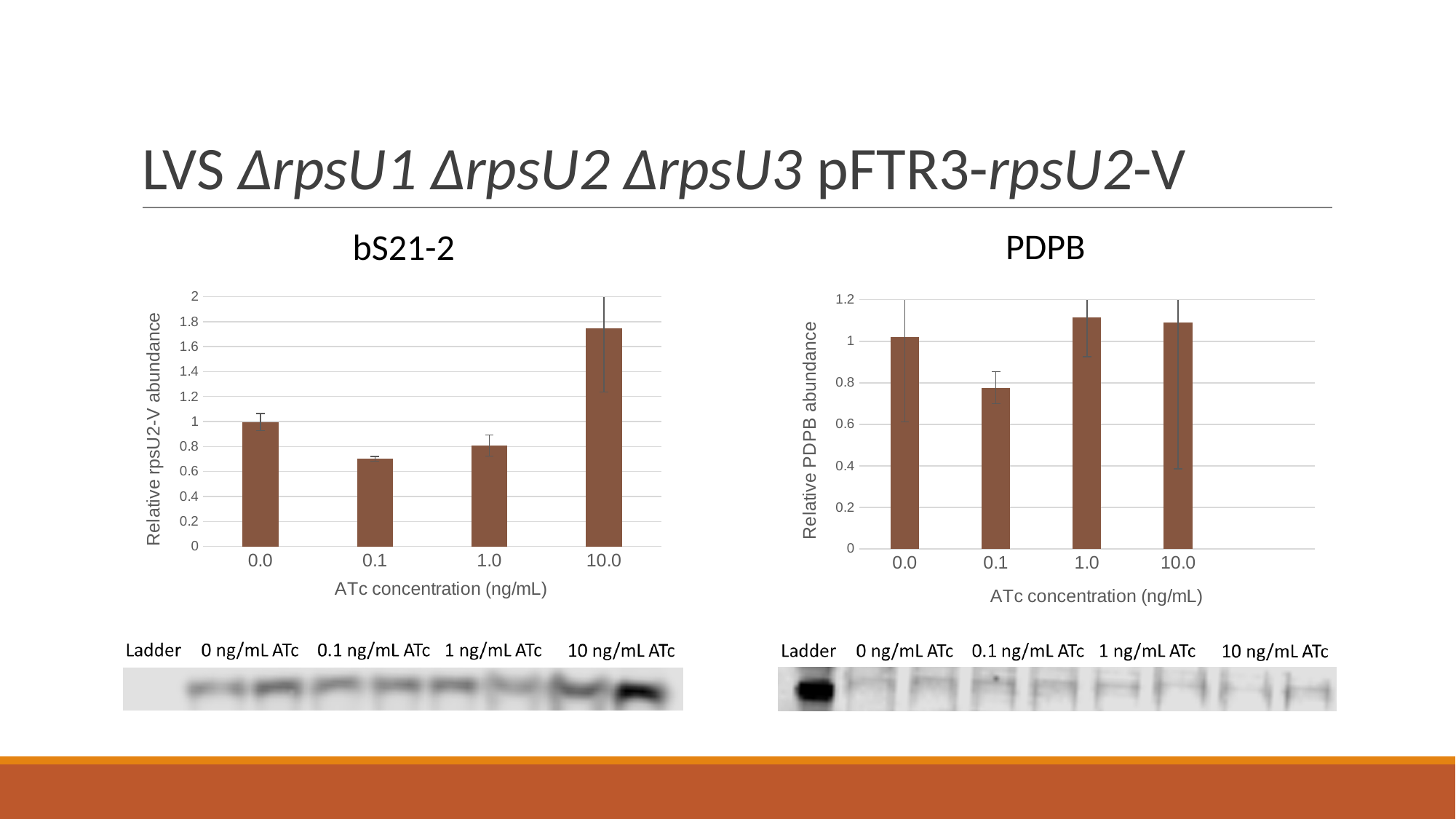
In the bS21-2 chart, which is larger, the value for 0.0 or the value for 1.0 ng/mL ATc? 0.0 In the PDPB chart, what is the label of the x axis? ATc concentration (ng/mL) In the bS21-2 chart, is the value for 0.1 ng/mL ATc greater or less than 0.8? less In the PDPB chart, which is larger, the value for 0.0 or the value for 0.1 ng/mL ATc? 0.0 In the bS21-2 chart, is the value for 10.0 ng/mL ATc greater or less than 1.6? greater In the PDPB chart, which ATc concentration has the lowest relative PDPB abundance? 0.1 In the bS21-2 chart, how many ATc concentration categories are plotted? 4 In the bS21-2 chart, what kind of chart is shown? bar chart In the bS21-2 chart, which ATc concentration has the highest relative rpsU2-V abundance? 10.0 In the bS21-2 chart, which ATc concentration has the lowest relative rpsU2-V abundance? 0.1 In the bS21-2 chart, what is the label of the y axis? Relative rpsU2-V abundance